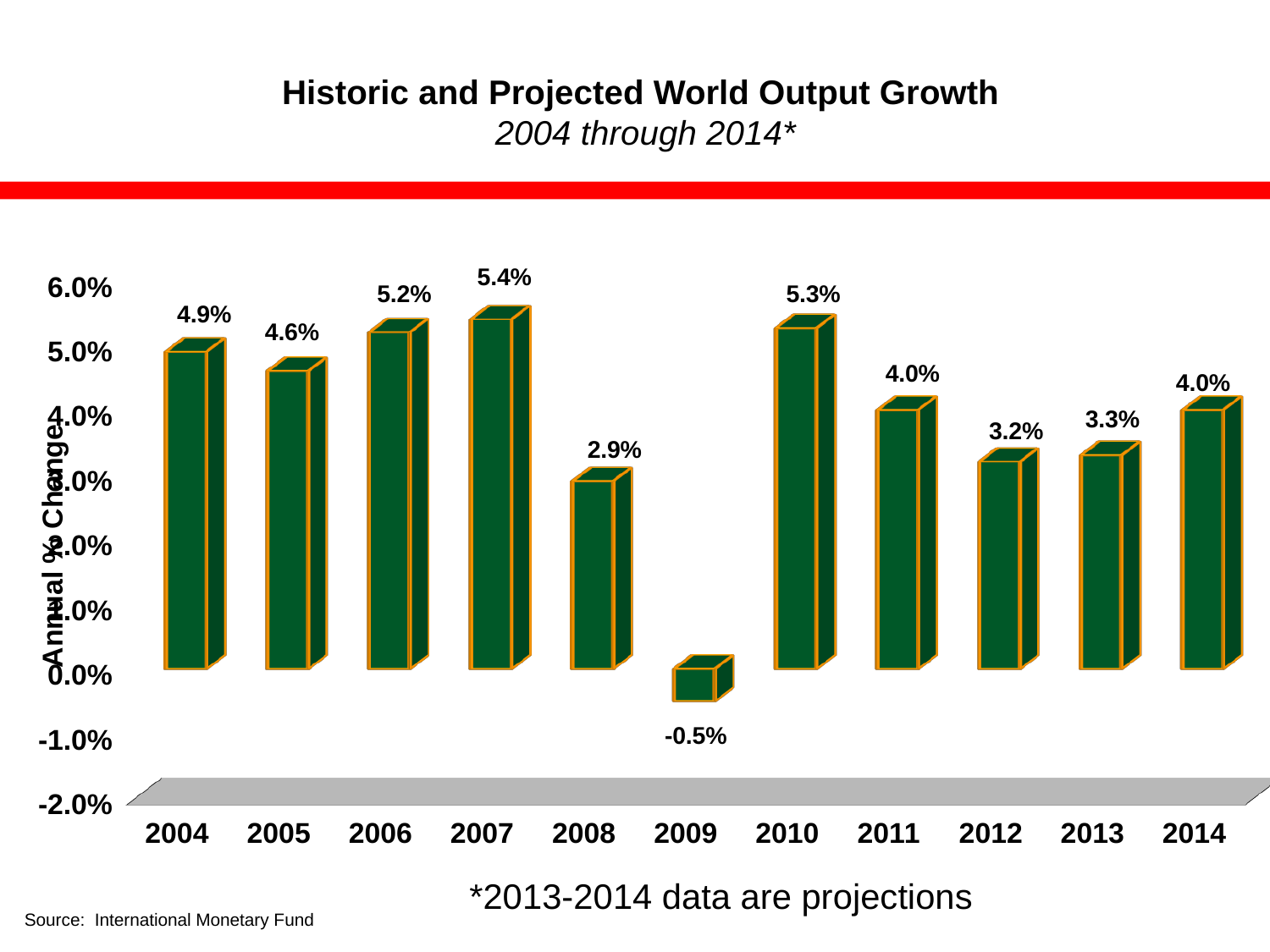
What is the difference between the values for 2010 and 2008? 2.4% What is the value shown for 2009? -0.5% What kind of chart is shown on the slide? bar chart What is the title of the chart? Historic and Projected World Output Growth Do the values rise or fall from 2010 to 2012? fall Is the value for 2013 greater or less than 4.0%? less Which year has the highest world output growth? 2007 What is the value shown for 2012? 3.2% Which year has the lowest world output growth? 2009 What is the world output growth value for 2007? 5.4% How many years are shown on the x axis? 11 Which is larger, the value for 2004 or the value for 2005? 2004